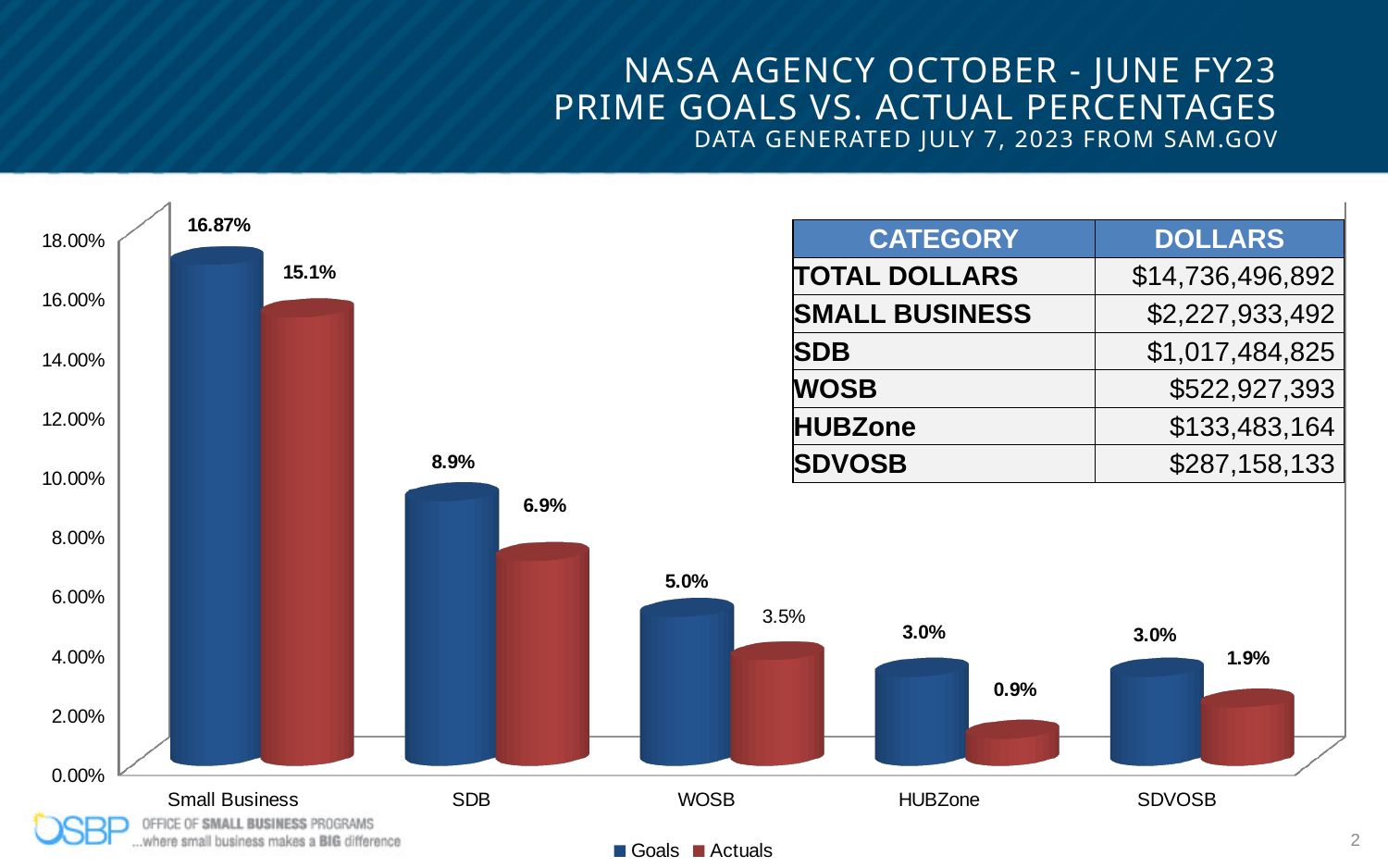
How many series does the chart legend list? 2 What is the Goals value for WOSB? 5.0% What is the Actuals value for HUBZone? 0.9% What is the Actuals value for SDB? 6.9% What is the Goals value for Small Business? 16.87% Which category has the lowest Actuals value? HUBZone What kind of chart is shown on the slide? Bar chart How many categories are shown on the x axis of the chart? 5 Is the Actuals value for Small Business greater or less than 14.00%? greater Which category has the highest Actuals value? Small Business What is the difference between the Goals and Actuals values for SDB? 2.0 percentage points Which is larger, the Actuals value for WOSB or the Actuals value for SDVOSB? WOSB